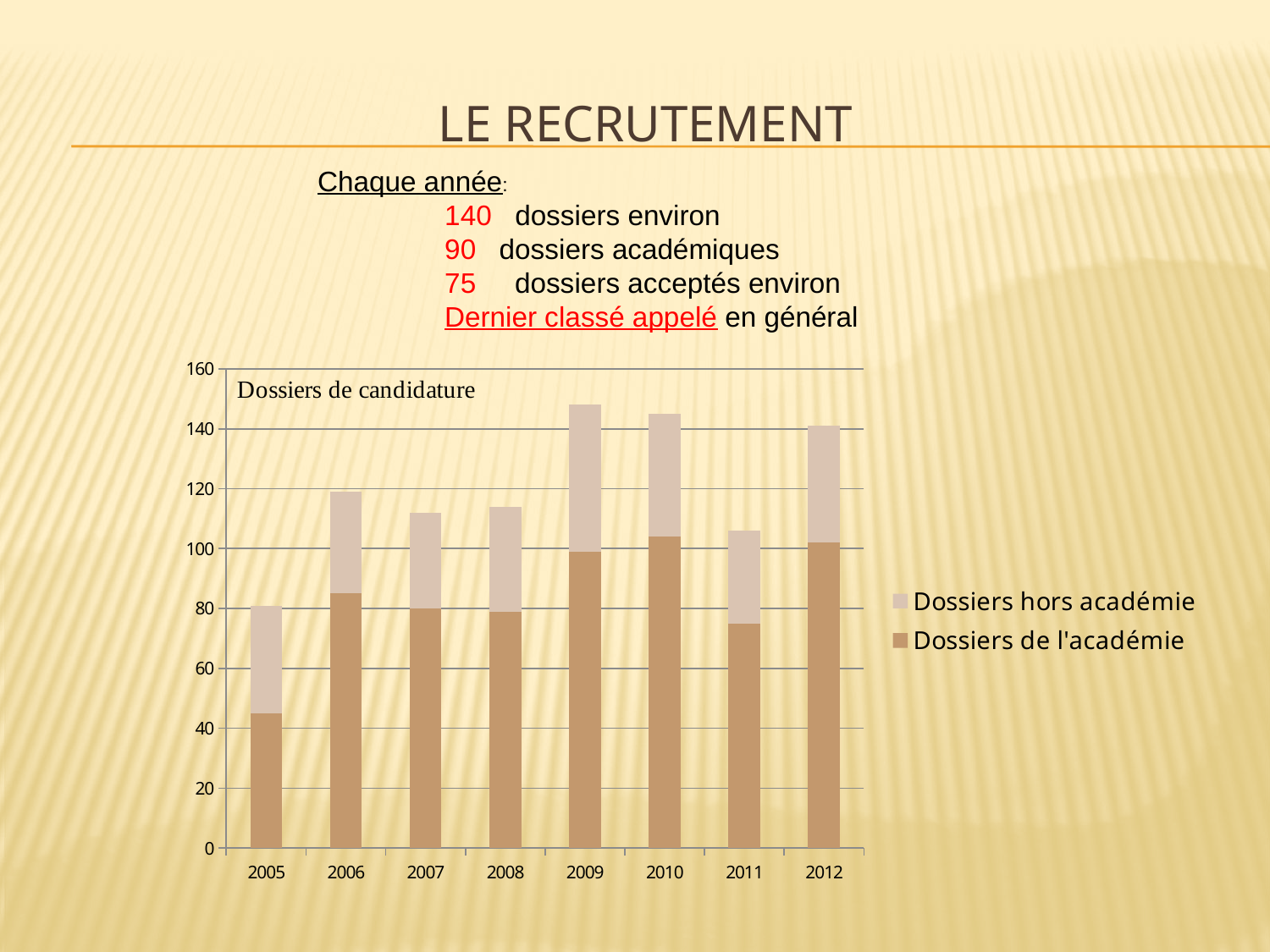
Is the value for Dossiers de l'académie in 2010 greater or less than 100? greater Does the total bar rise or fall from 2010 to 2011? fall Is the total bar for 2005 greater or less than 100? less Which series is shown in the lighter colour in the chart? Dossiers hors académie How many years are shown on the x axis of the chart? 8 Which year has the lowest value for Dossiers de l'académie? 2005 What is the title shown inside the chart? Dossiers de candidature How many series does the chart legend list? 2 What kind of chart is shown on the slide? Stacked bar chart Which year has the larger total bar, 2011 or 2012? 2012 Which year has the lowest total number of dossiers de candidature? 2005 Is the total bar for 2009 greater or less than 140? greater